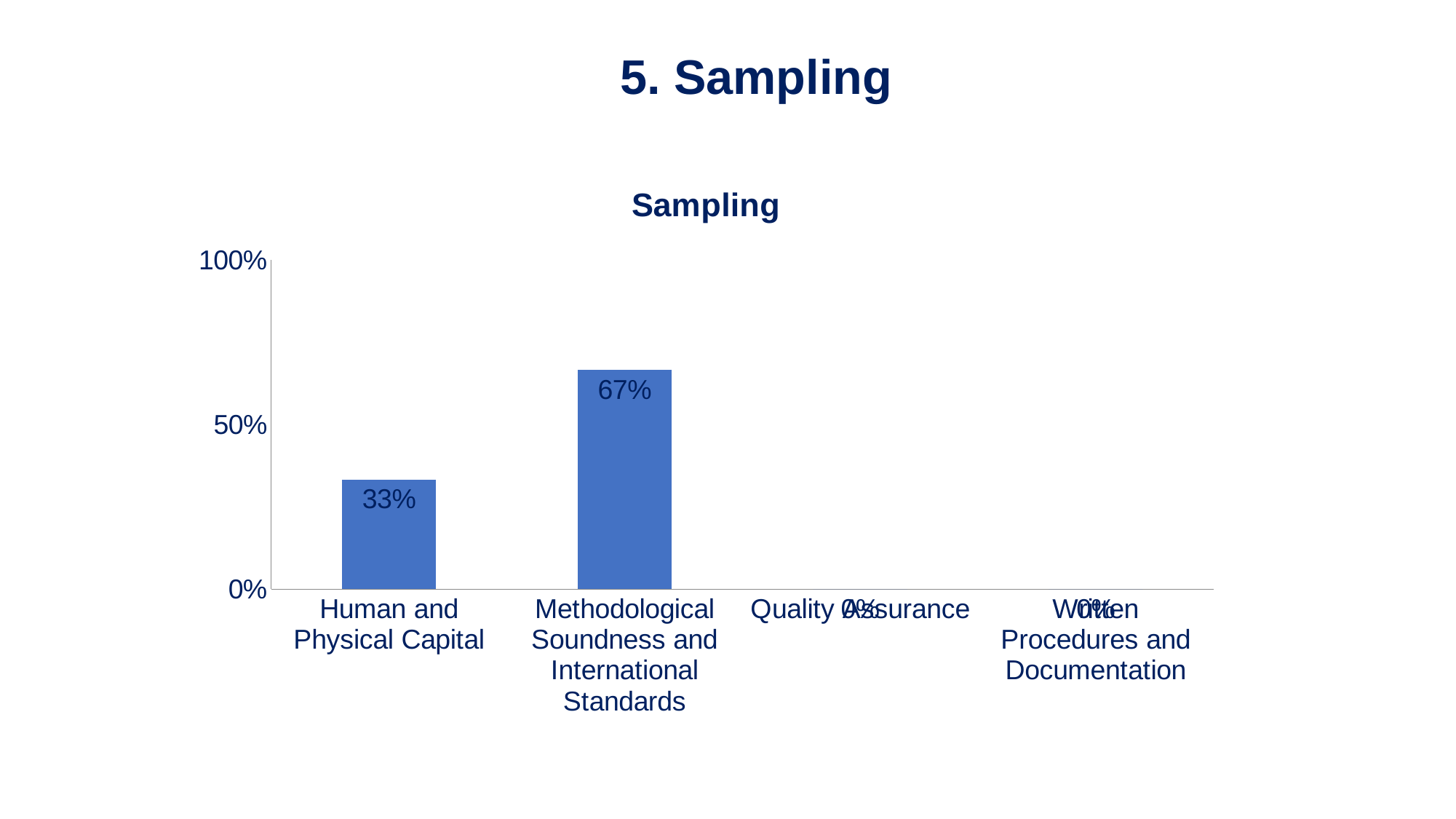
What is the title of the chart? Sampling Is the value for Human and Physical Capital greater or less than 50%? less Which category has the highest value? Methodological Soundness and International Standards What is the value for Quality Assurance? 0% What kind of chart is shown? bar chart What is the value for Methodological Soundness and International Standards? 67% What is the value for Written Procedures and Documentation? 0% Is the value for Methodological Soundness and International Standards greater or less than 50%? greater Which is larger, the value for Human and Physical Capital or the value for Methodological Soundness and International Standards? Methodological Soundness and International Standards What is the value for Human and Physical Capital? 33% How many categories are shown on the x axis? 4 What is the difference between the values for Methodological Soundness and International Standards and Human and Physical Capital? 34%